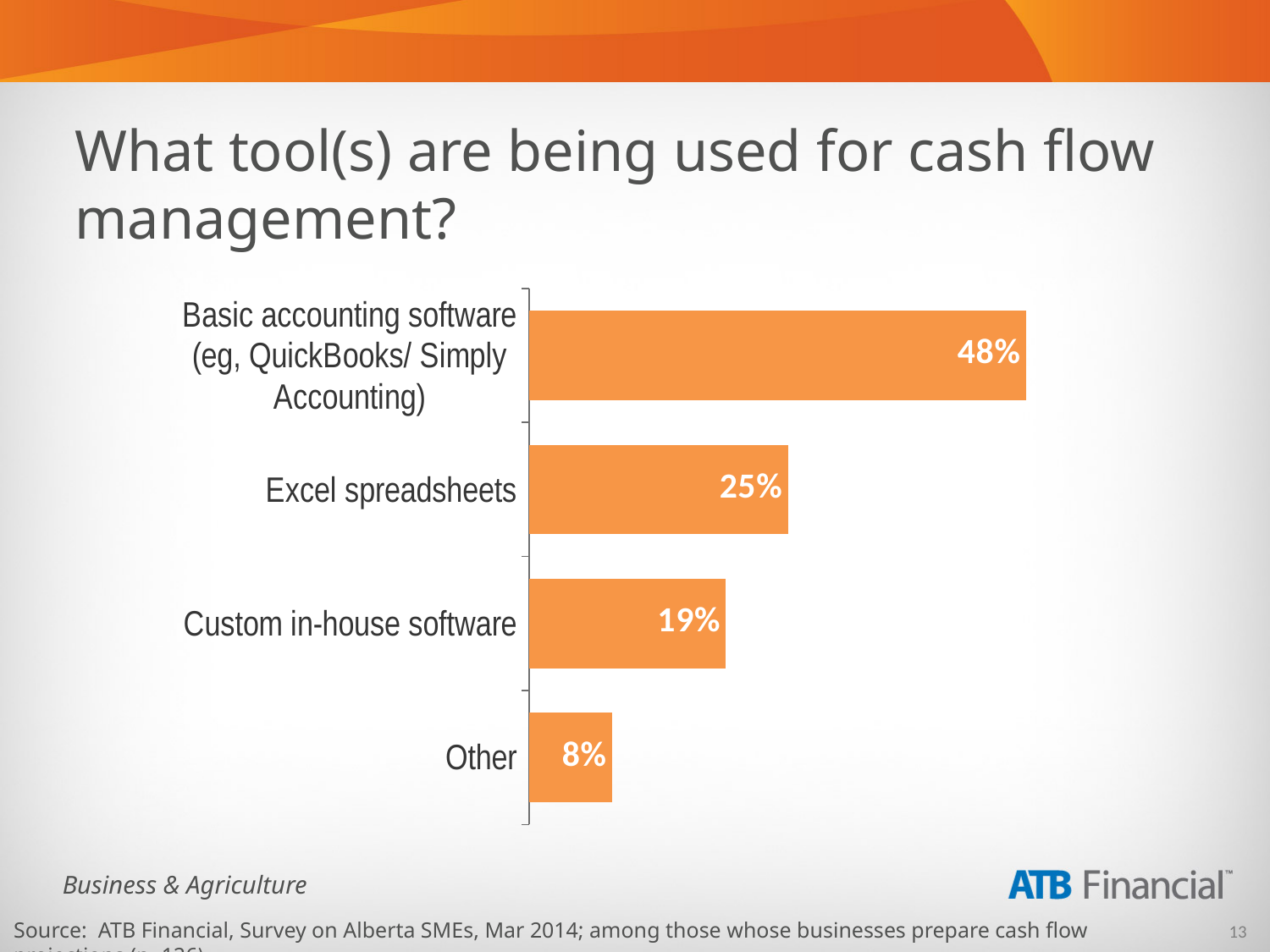
What is the difference between the values for Excel spreadsheets and custom in-house software? 6% Which is larger: the value for custom in-house software or the value for Other? Custom in-house software What is the difference in percentage points between basic accounting software and Excel spreadsheets? 23 Which tool has the highest percentage on the chart? Basic accounting software (eg, QuickBooks/ Simply Accounting) Which category has the lowest value on the chart? Other What is the value shown for Excel spreadsheets? 25% What type of chart is shown on the slide? Bar chart How many categories are shown on the chart? 4 What is the value for the Other category? 8% What percentage is shown for custom in-house software? 19% What percentage of respondents use basic accounting software (eg, QuickBooks/ Simply Accounting) for cash flow management? 48% What is the title of the slide containing the chart? What tool(s) are being used for cash flow management?